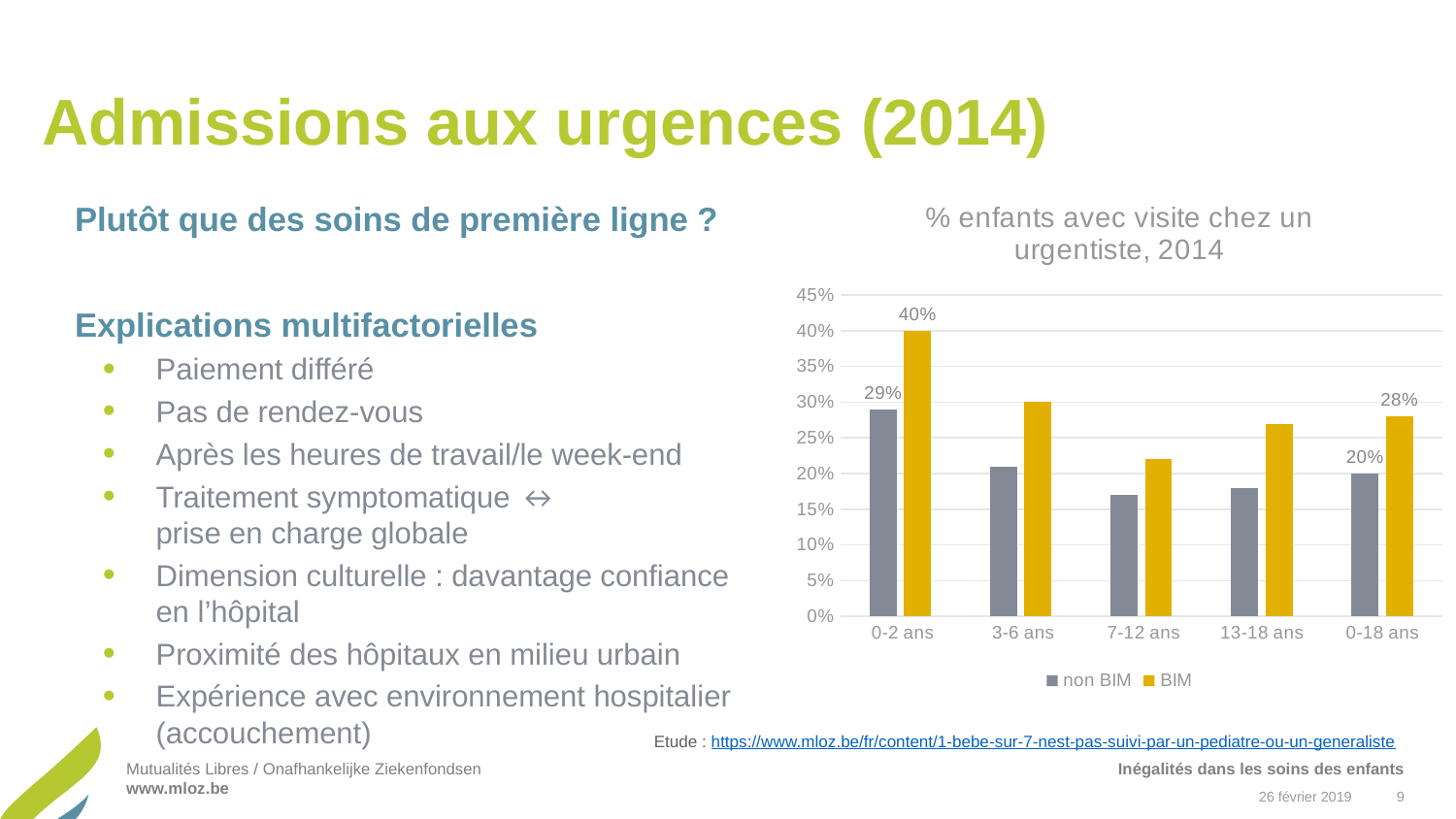
Is the non BIM value for 3-6 ans greater or less than 25%? less What is the difference between the BIM and non BIM values for 0-2 ans? 11 percentage points What is the value for non BIM children in the 0-18 ans category? 20% What is the difference between the BIM and non BIM values for 0-18 ans? 8 percentage points Which age category has the highest BIM value? 0-2 ans What is the value for BIM children in the 0-18 ans category? 28% What percentage of non BIM children aged 0-2 ans had a visit to an emergency doctor in 2014? 29% Is the BIM value for 13-18 ans greater or less than 25%? greater How many series does the legend list? 2 Which age category has the lowest BIM value? 7-12 ans What is the value for BIM children in the 0-2 ans category? 40% How many age categories are shown on the x axis? 5